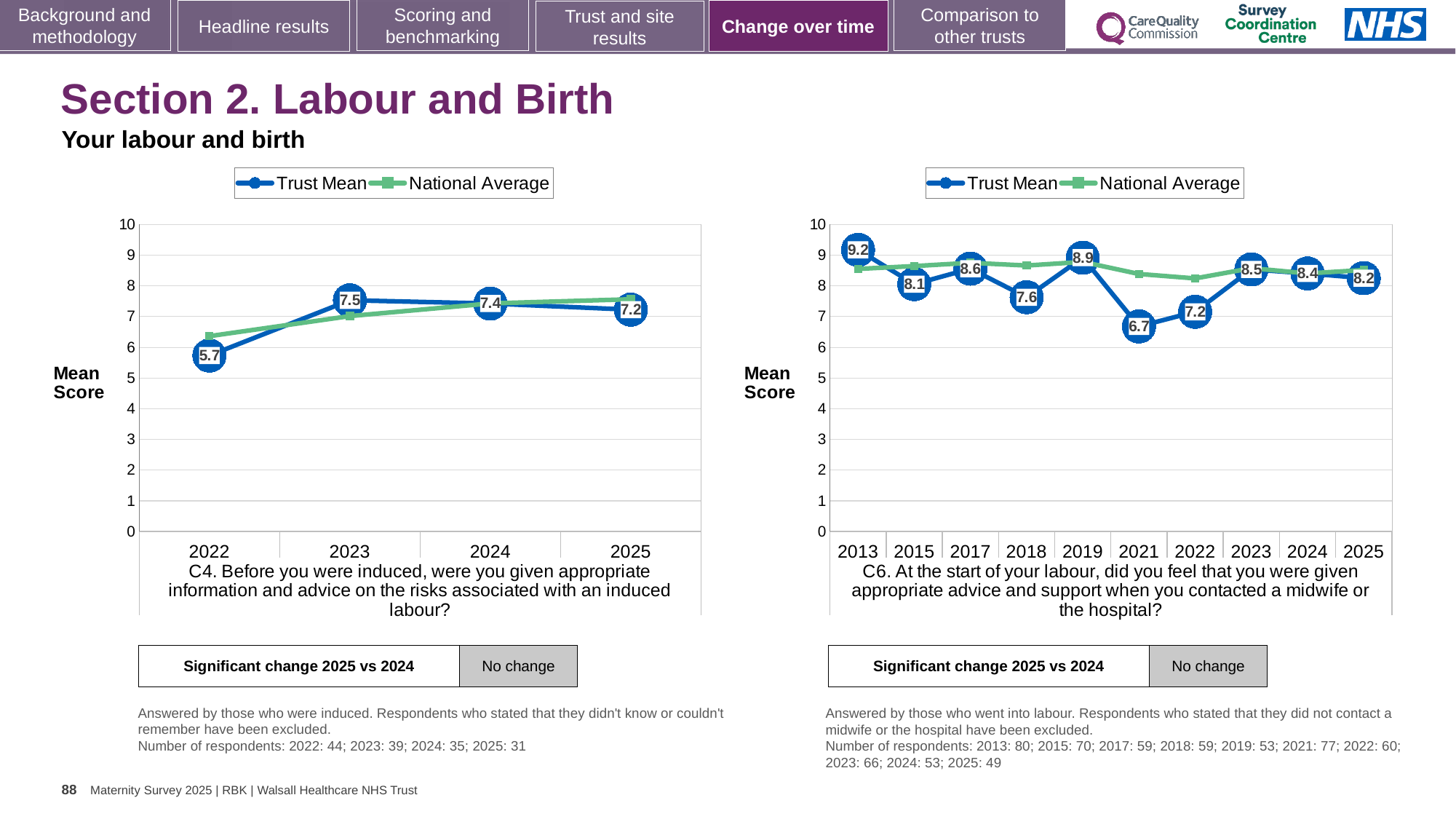
In the right chart (C6), is the Trust Mean higher in 2018 or in 2022? 2018 In the left chart (C4), what is the Trust Mean for 2022? 5.7 In the left chart (C4), how many years are shown on the x axis? 4 In the right chart (C6), how many years are shown on the x axis? 10 How many series does the legend of the right chart (C6) list? 2 In the right chart (C6), which year has the lowest Trust Mean? 2021 In the right chart (C6), what is the Trust Mean for 2021? 6.7 In the left chart (C4), what is the Trust Mean for 2025? 7.2 In the left chart (C4), which year has the highest Trust Mean? 2023 In the left chart (C4), what is the difference between the Trust Mean in 2023 and in 2022? 1.8 In the right chart (C6), which year has the highest Trust Mean? 2013 In the right chart (C6), what is the Trust Mean for 2019? 8.9